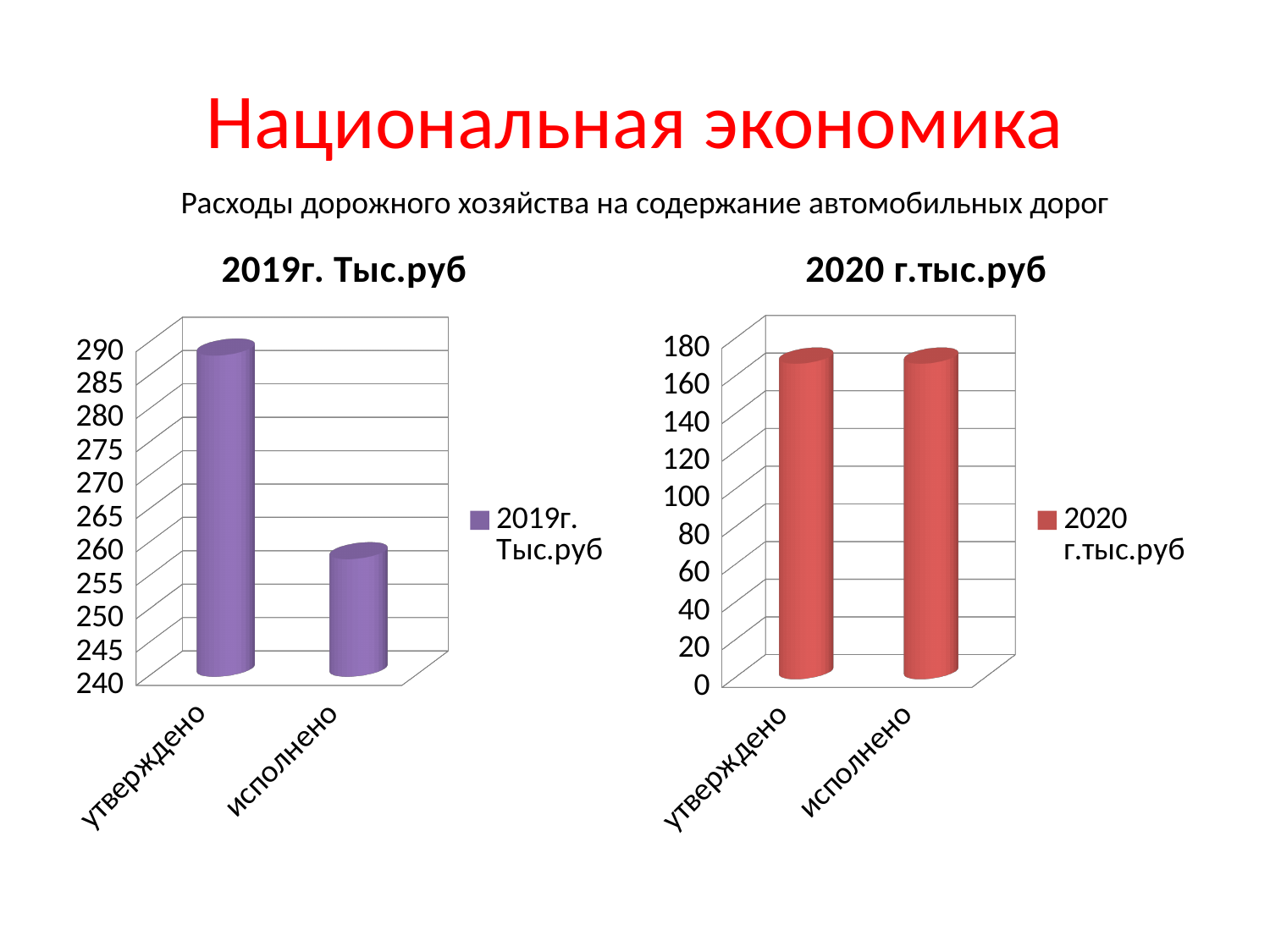
In the chart titled "2019г. Тыс.руб", which category has the lowest value? исполнено In the chart titled "2019г. Тыс.руб", is the value for утверждено greater or less than 280? greater In the chart titled "2020 г.тыс.руб", is the value for утверждено greater or less than 140? greater In the chart titled "2019г. Тыс.руб", is the value for исполнено greater or less than 270? less How many categories are shown in the chart titled "2020 г.тыс.руб"? 2 In the chart titled "2019г. Тыс.руб", which category has the highest value? утверждено How many series does the legend of the chart titled "2020 г.тыс.руб" list? 1 In the chart titled "2019г. Тыс.руб", which is larger, утверждено or исполнено? утверждено What kind of chart is the chart titled "2019г. Тыс.руб"? bar chart What is the legend entry of the chart on the left of the slide? 2019г. Тыс.руб In the chart titled "2019г. Тыс.руб", do the values rise or fall from утверждено to исполнено? fall